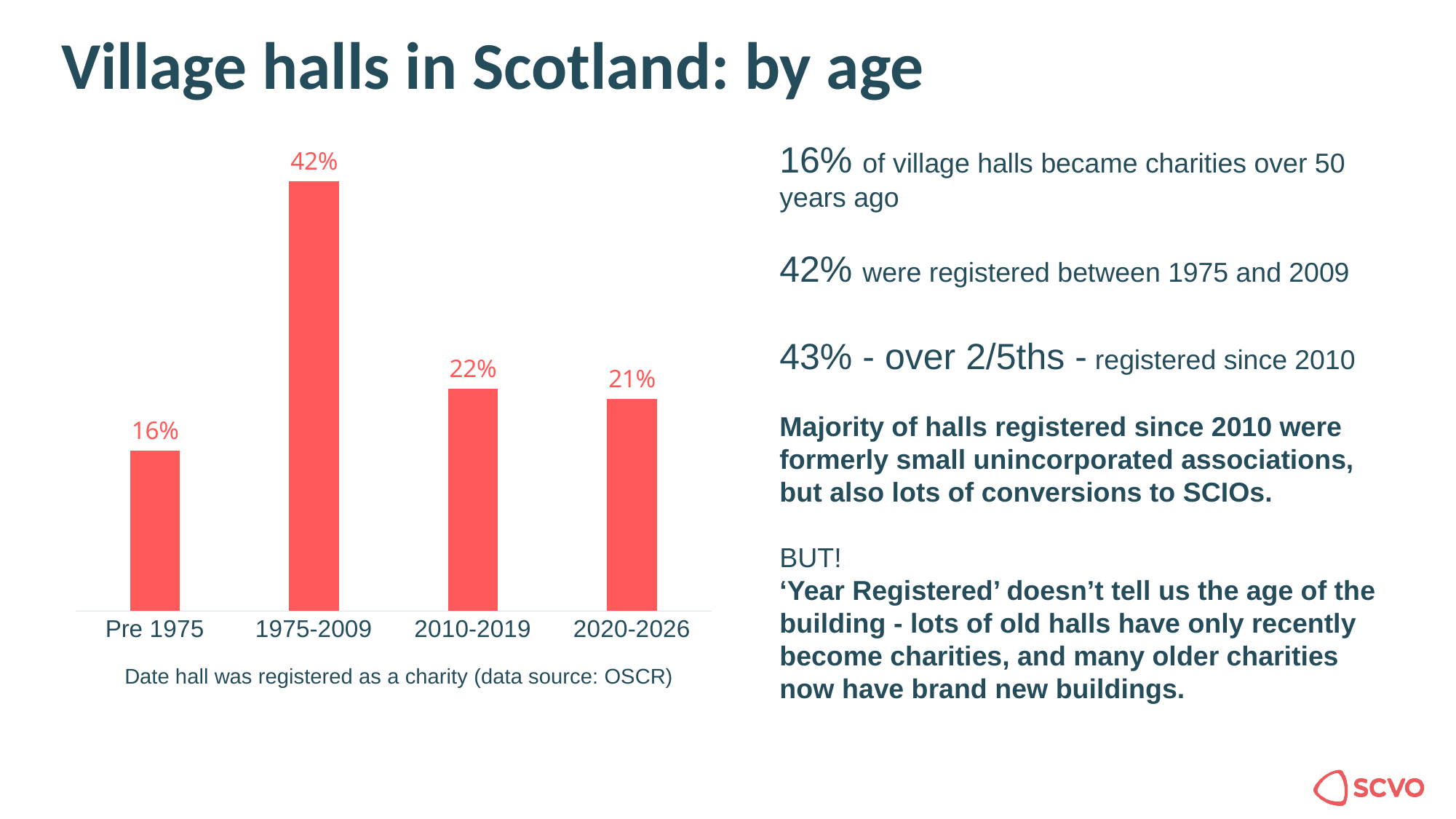
What percentage of village halls were registered as charities in 1975-2009? 42% How many categories are shown on the x axis of the chart? 4 Which registration period has the highest percentage of village halls? 1975-2009 What is the difference in percentage points between the 1975-2009 bar and the Pre 1975 bar? 26 What is the combined percentage for the 2010-2019 and 2020-2026 bars? 43% What does the caption below the chart say the x axis represents? Date hall was registered as a charity (data source: OSCR) What is the value shown for the Pre 1975 category? 16% Which is larger, the value for 2010-2019 or the value for 2020-2026? 2010-2019 What is the value for the 2020-2026 bar? 21% What percentage is shown for 2010-2019? 22% Which registration period has the lowest percentage of village halls? Pre 1975 What kind of chart is shown on the slide? Bar chart